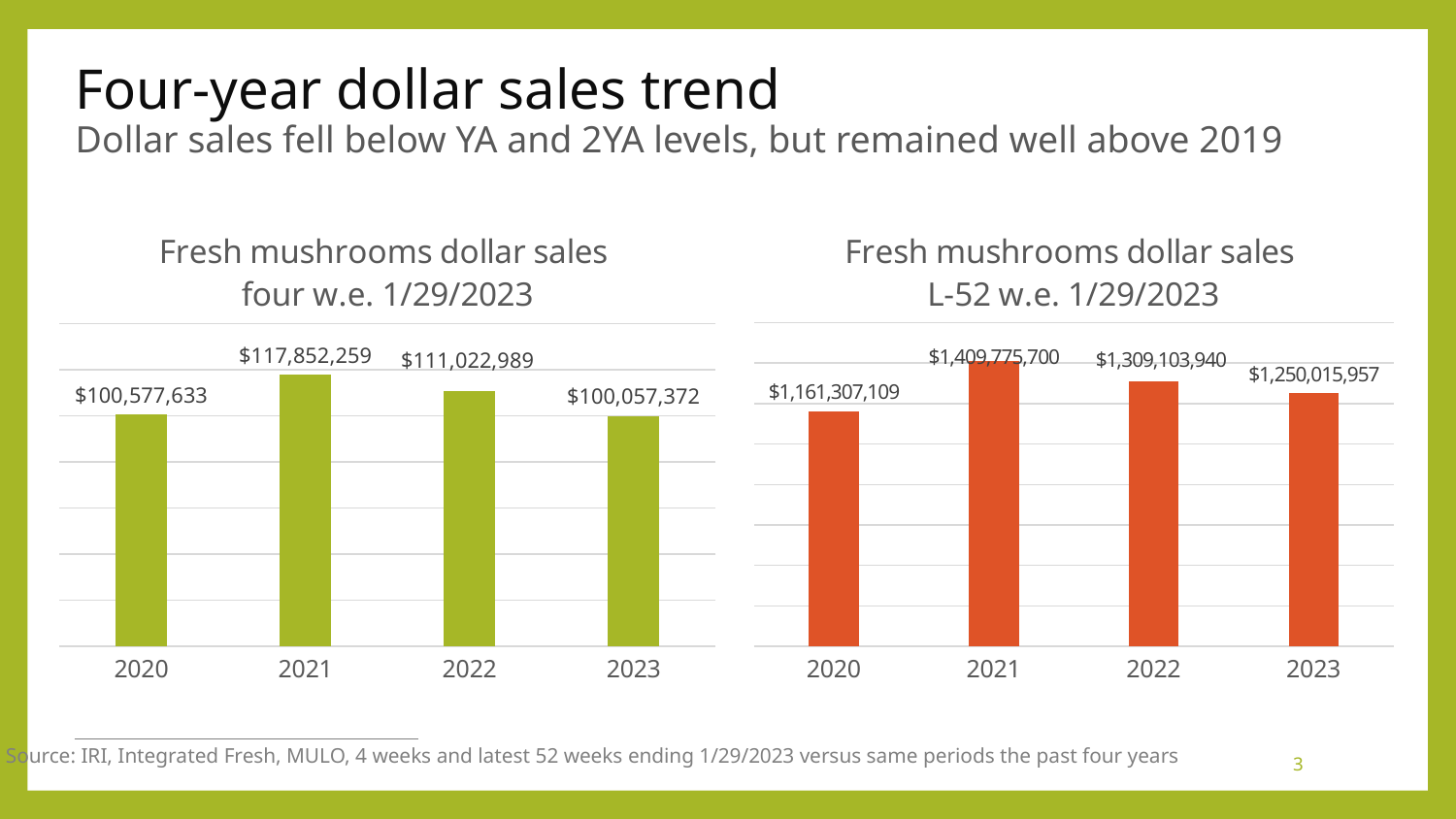
In the right chart (L-52 w.e. 1/29/2023), which year has the lowest dollar sales? 2020 How many years are shown in the chart titled 'Fresh mushrooms dollar sales L-52 w.e. 1/29/2023'? 4 In the left chart (four w.e. 1/29/2023), which is larger, the value for 2020 or the value for 2023? 2020 What type of chart is the 'Fresh mushrooms dollar sales four w.e. 1/29/2023' chart? Bar chart In the left chart (four w.e. 1/29/2023), which year has the highest dollar sales? 2021 In the left chart (four w.e. 1/29/2023), what is the difference between the 2021 and 2022 values? $6,829,270 In the left chart (four w.e. 1/29/2023), what is the value for 2020? $100,577,633 In the right chart (L-52 w.e. 1/29/2023), what is the difference between the 2021 and 2023 values? $159,759,743 In the right chart (L-52 w.e. 1/29/2023), which year has the highest dollar sales? 2021 In the right chart (L-52 w.e. 1/29/2023), do the values rise or fall from 2021 to 2023? Fall In the chart titled 'Fresh mushrooms dollar sales four w.e. 1/29/2023', what is the value for 2021? $117,852,259 In the chart titled 'Fresh mushrooms dollar sales L-52 w.e. 1/29/2023', what is the value for 2023? $1,250,015,957